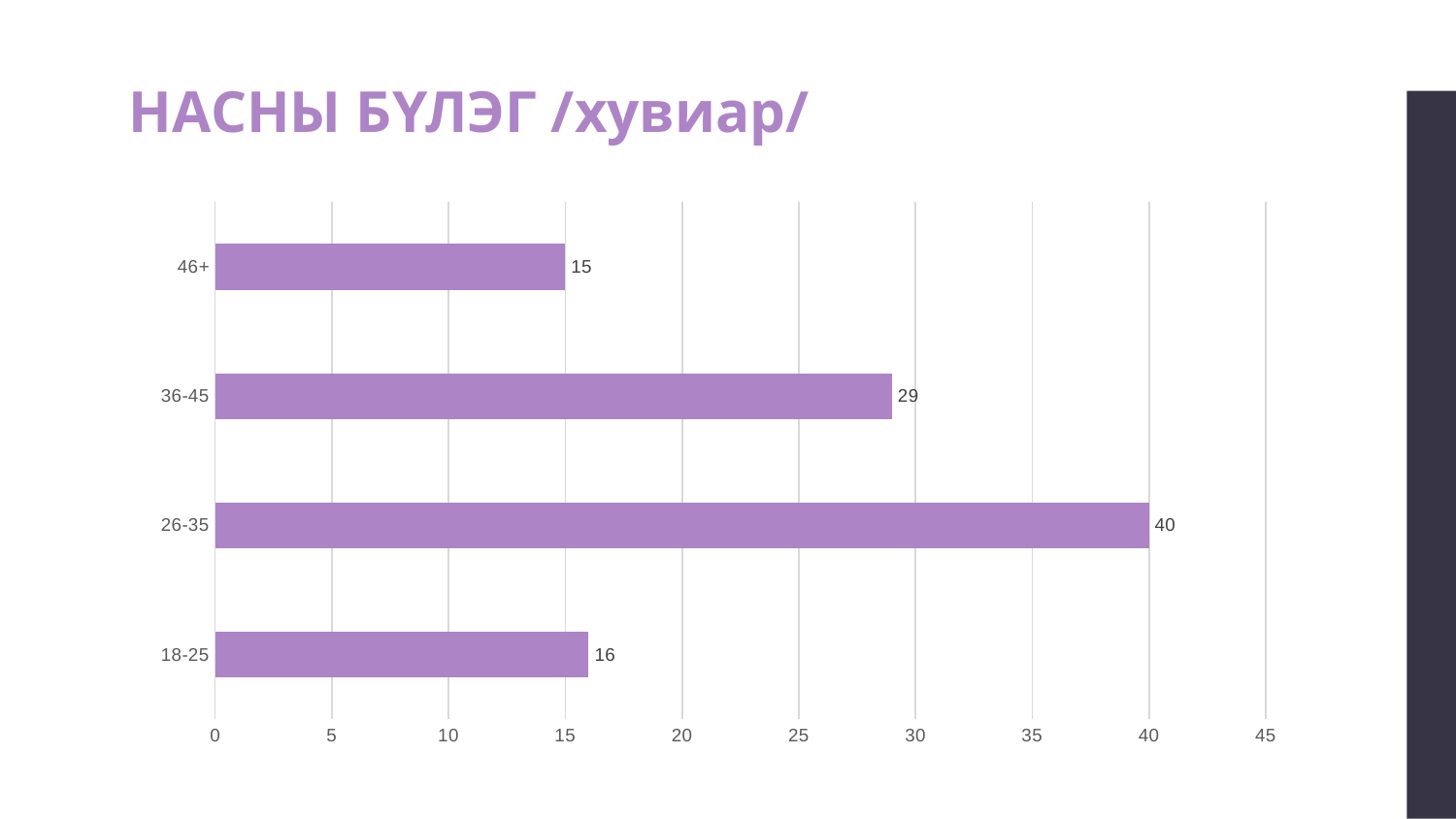
Which age group has the lowest value? 46+ What is the difference between the values for 26-35 and 36-45? 11 What is the value for the 46+ age group? 15 What is the title of the slide? НАСНЫ БҮЛЭГ /хувиар/ What is the value for the 36-45 age group? 29 Which is larger, the value for 36-45 or the value for 18-25? 36-45 What is the difference between the values for 18-25 and 46+? 1 What kind of chart is shown on the slide? Bar chart Which age group has the highest value? 26-35 How many age groups are shown in the chart? 4 What is the value for the 26-35 age group? 40 What is the value for the 18-25 age group? 16